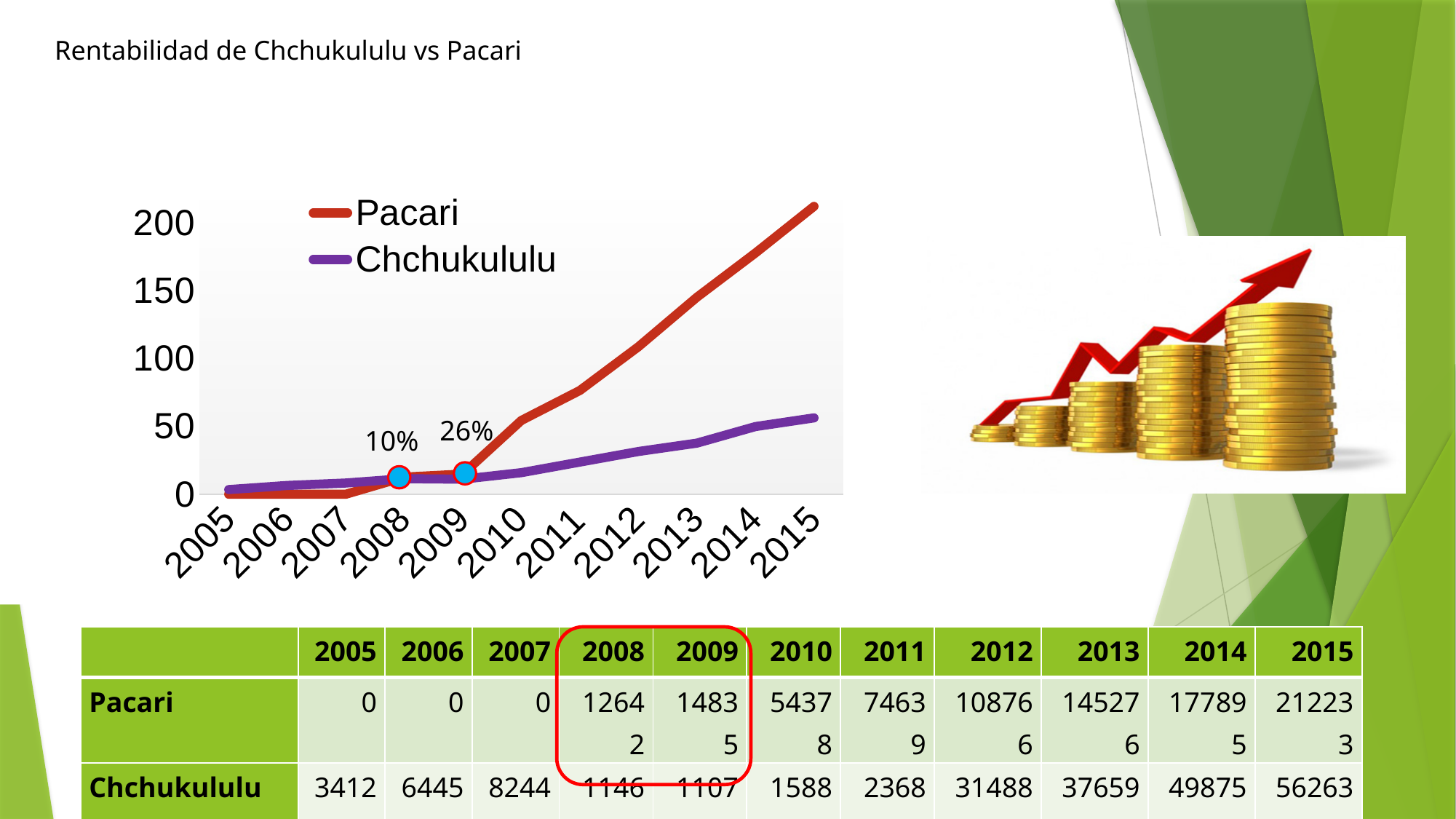
Does the Pacari line rise or fall from 2009 to 2015? rise Is the value for Pacari in 2013 greater or less than 100? greater Which series has the higher value in 2015, Pacari or Chchukululu? Pacari What percentage label is shown at the 2008 point on the chart? 10% How many years are shown along the x axis of the chart? 11 Is the value for Chchukululu in 2010 greater or less than 50? less Which series is drawn in red in the chart? Pacari What kind of chart is shown on the slide? line chart Which series has the higher value in 2006, Pacari or Chchukululu? Chchukululu Is the value for Chchukululu in 2015 greater or less than 50? greater How many series does the chart legend list? 2